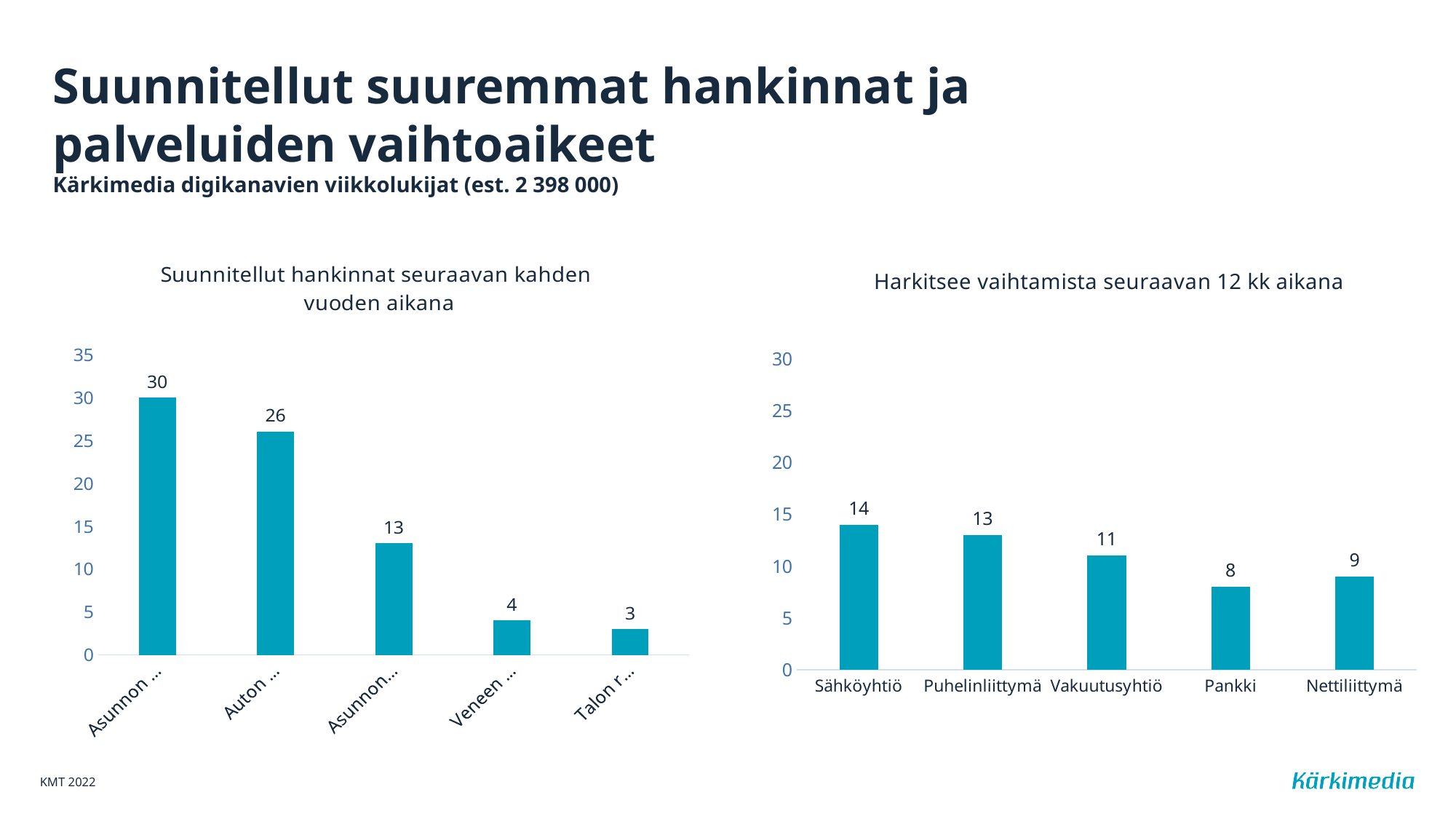
In the chart 'Harkitsee vaihtamista seuraavan 12 kk aikana', what is the difference between Vakuutusyhtiö and Nettiliittymä? 2 In the chart 'Suunnitellut hankinnat seuraavan kahden vuoden aikana', what is the difference between the first bar (30) and the bar for 'Veneen'? 26 In the chart 'Harkitsee vaihtamista seuraavan 12 kk aikana', what is the value for Sähköyhtiö? 14 In the chart 'Suunnitellut hankinnat seuraavan kahden vuoden aikana', what is the value for the category beginning 'Auton'? 26 In the chart 'Harkitsee vaihtamista seuraavan 12 kk aikana', which category has the highest value? Sähköyhtiö In the chart 'Harkitsee vaihtamista seuraavan 12 kk aikana', which is larger, Puhelinliittymä or Nettiliittymä? Puhelinliittymä In the chart 'Harkitsee vaihtamista seuraavan 12 kk aikana', which category has the lowest value? Pankki How many categories are shown in the chart 'Harkitsee vaihtamista seuraavan 12 kk aikana'? 5 In the chart 'Suunnitellut hankinnat seuraavan kahden vuoden aikana', what is the value of the first (leftmost) bar? 30 In the chart 'Suunnitellut hankinnat seuraavan kahden vuoden aikana', do the values rise or fall from left to right? Fall In the chart 'Harkitsee vaihtamista seuraavan 12 kk aikana', what is the value for Pankki? 8 What type of chart is 'Suunnitellut hankinnat seuraavan kahden vuoden aikana'? Bar chart